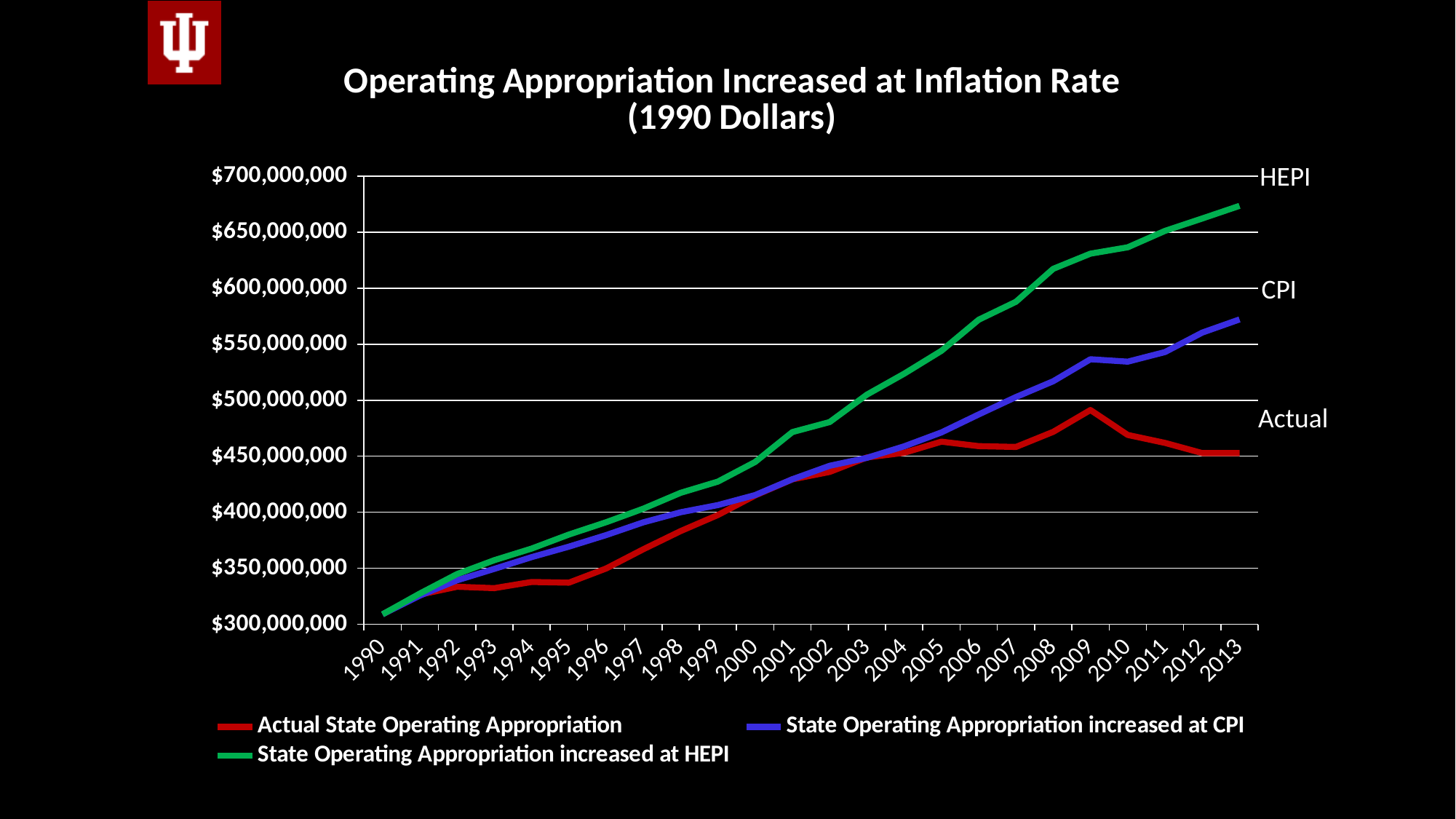
Does the Actual State Operating Appropriation rise or fall from 2009 to 2013? fall In 2009, is the Actual State Operating Appropriation higher or lower than the CPI series? lower Is the value for the Actual State Operating Appropriation in 2013 greater or less than $500,000,000? less Is the value for the HEPI series in 2013 greater or less than $650,000,000? greater What colour is the line for the Actual State Operating Appropriation? red In which year does the Actual State Operating Appropriation reach its highest value? 2009 Is the value for the CPI series in 2013 greater or less than $550,000,000? greater What kind of chart is shown on the slide? line chart How many years are plotted along the x axis? 24 How many series does the legend list? 3 Which series has the highest value in 2013? State Operating Appropriation increased at HEPI Which series has the lowest value in 2013? Actual State Operating Appropriation